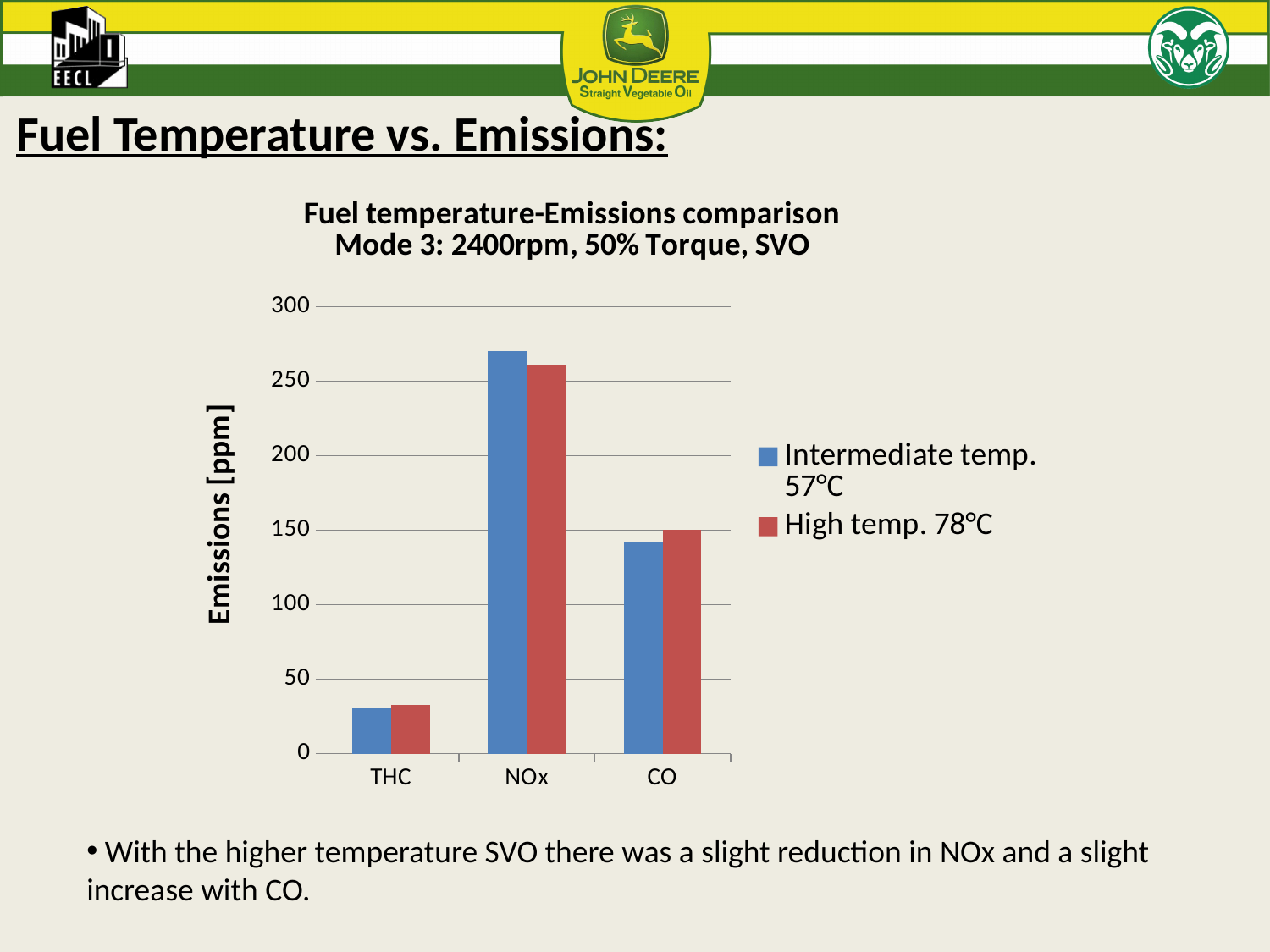
Which emission category has the lowest value for the High temp. 78°C series? THC Is the NOx value for Intermediate temp. 57°C greater or less than 250? greater Is the CO value for Intermediate temp. 57°C greater or less than 150? less For CO, which series has the larger value, Intermediate temp. 57°C or High temp. 78°C? High temp. 78°C For NOx, which series has the larger value, Intermediate temp. 57°C or High temp. 78°C? Intermediate temp. 57°C Is the THC value for High temp. 78°C greater or less than 50? less What is the label of the y axis? Emissions [ppm] How many emission categories are shown on the x axis? 3 Which emission category has the highest value for the Intermediate temp. 57°C series? NOx What kind of chart is shown on the slide? bar chart How many series does the legend list? 2